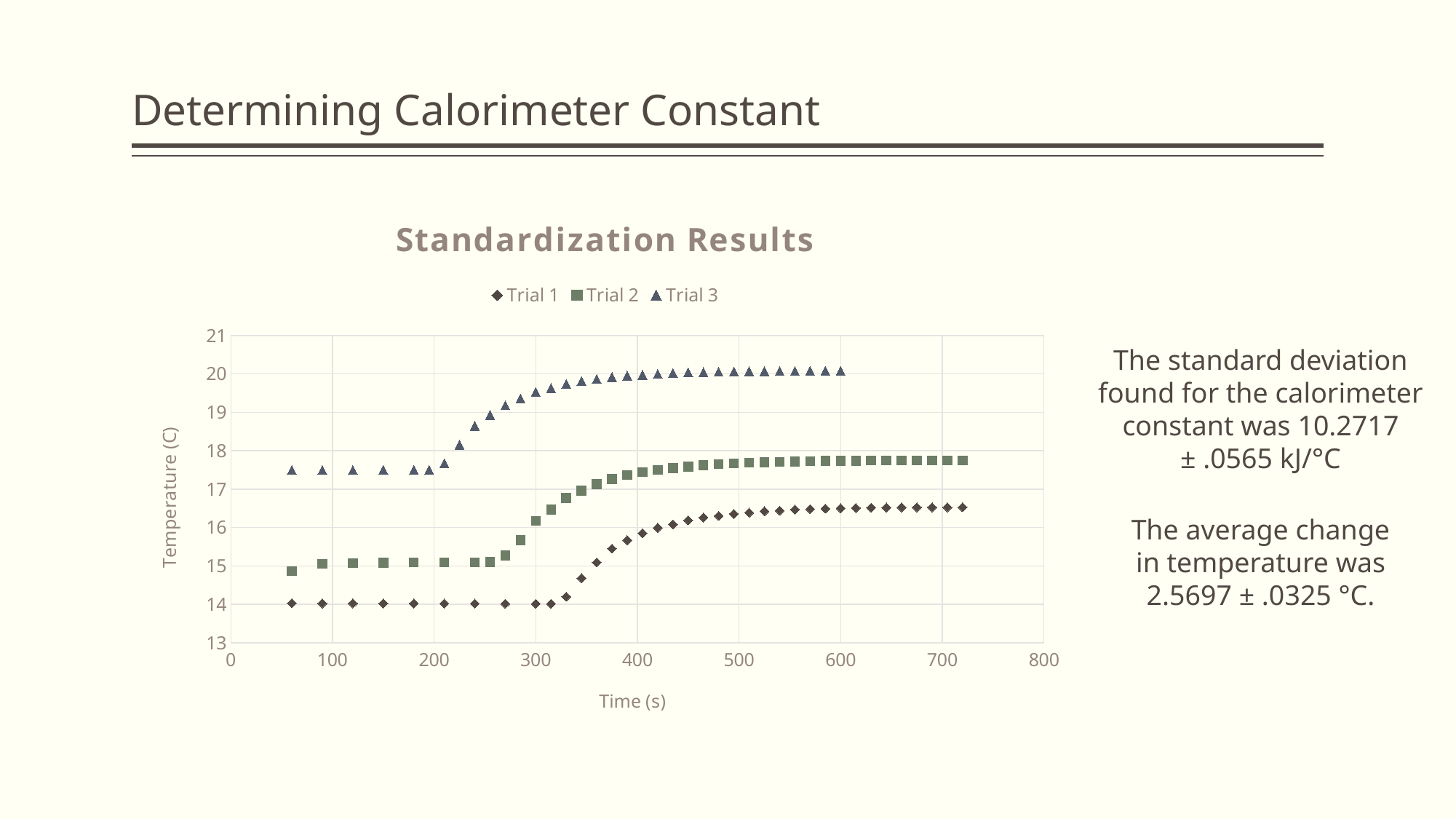
What is the label of the y axis of the chart? Temperature (C) At 500 s, which series has the higher temperature, Trial 1 or Trial 3? Trial 3 Do the Trial 2 temperature values rise or fall as time increases along the x axis? rise What is the title of the chart on the slide? Standardization Results Is the Trial 3 temperature at 400 s greater or less than 19? greater Is the Trial 1 temperature at 700 s greater or less than 16? greater How many series does the legend of the Standardization Results chart list? 3 What kind of chart is shown on the slide? Scatter chart Is the Trial 1 temperature at 100 s greater or less than 15? less Which series reaches the highest temperature on the chart? Trial 3